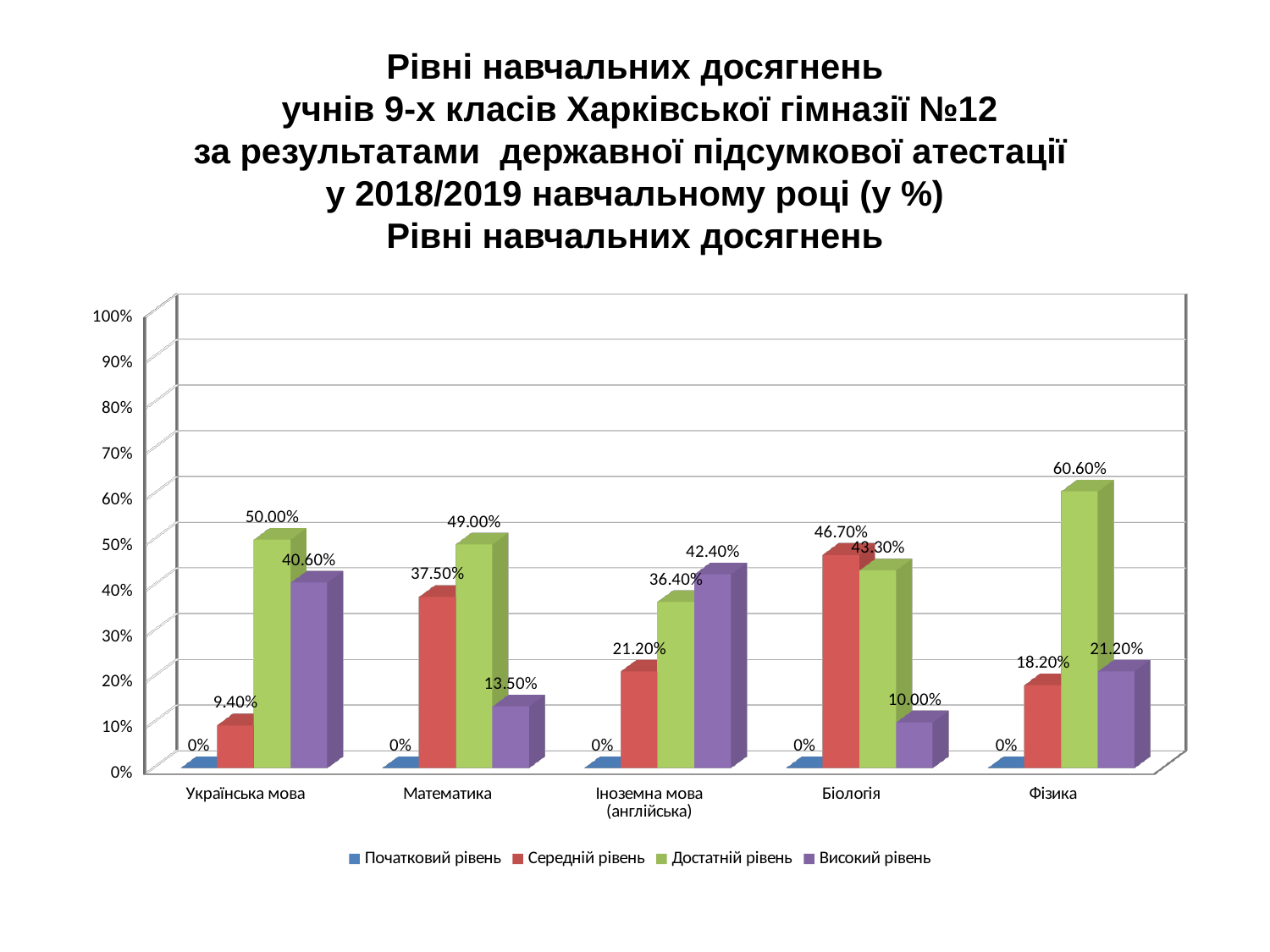
Which colour represents Високий рівень in the legend? Purple How many subjects are shown on the x axis? 5 What is the value of Достатній рівень for Фізика? 60.60% What is the difference between Достатній рівень and Високий рівень for Українська мова? 9.40% What kind of chart is shown on the slide? Bar chart What is the value of Середній рівень for Математика? 37.50% What is the value of Початковий рівень for Біологія? 0% Which subject has the highest value for Достатній рівень? Фізика Which is larger for Біологія: Середній рівень or Достатній рівень? Середній рівень Which subject has the lowest value for Високий рівень? Біологія What is the value of Високий рівень for Іноземна мова (англійська)? 42.40% How many series does the legend list? 4